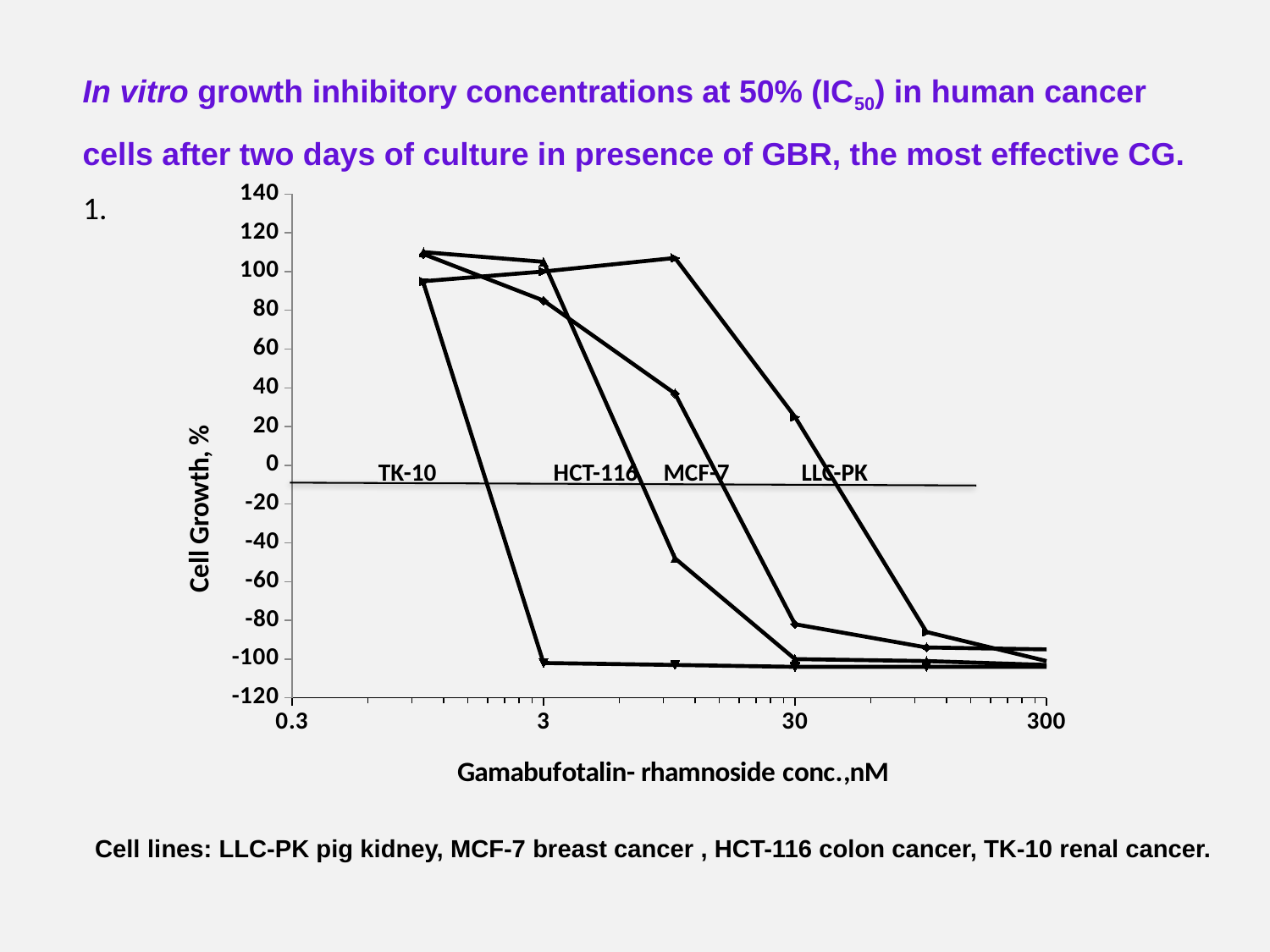
Is the cell growth for TK-10 at 3 nM greater or less than -80? less What is the title of the x axis of the chart? Gamabufotalin- rhamnoside conc.,nM What is the title of the y axis of the chart? Cell Growth, % At 30 nM, which cell line shows higher cell growth, LLC-PK or MCF-7? LLC-PK How many concentration values are labelled on the x axis? 4 What kind of chart is shown on the slide? line chart Do the cell growth values rise or fall as the concentration increases along the x axis? fall How many cell lines are plotted in the chart? 4 Which cell line has the lowest cell growth at 3 nM? TK-10 Which cell line has the highest cell growth at 30 nM? LLC-PK Is the cell growth for LLC-PK at 30 nM greater or less than 0? greater Is the cell growth for HCT-116 at 10 nM greater or less than -20? less